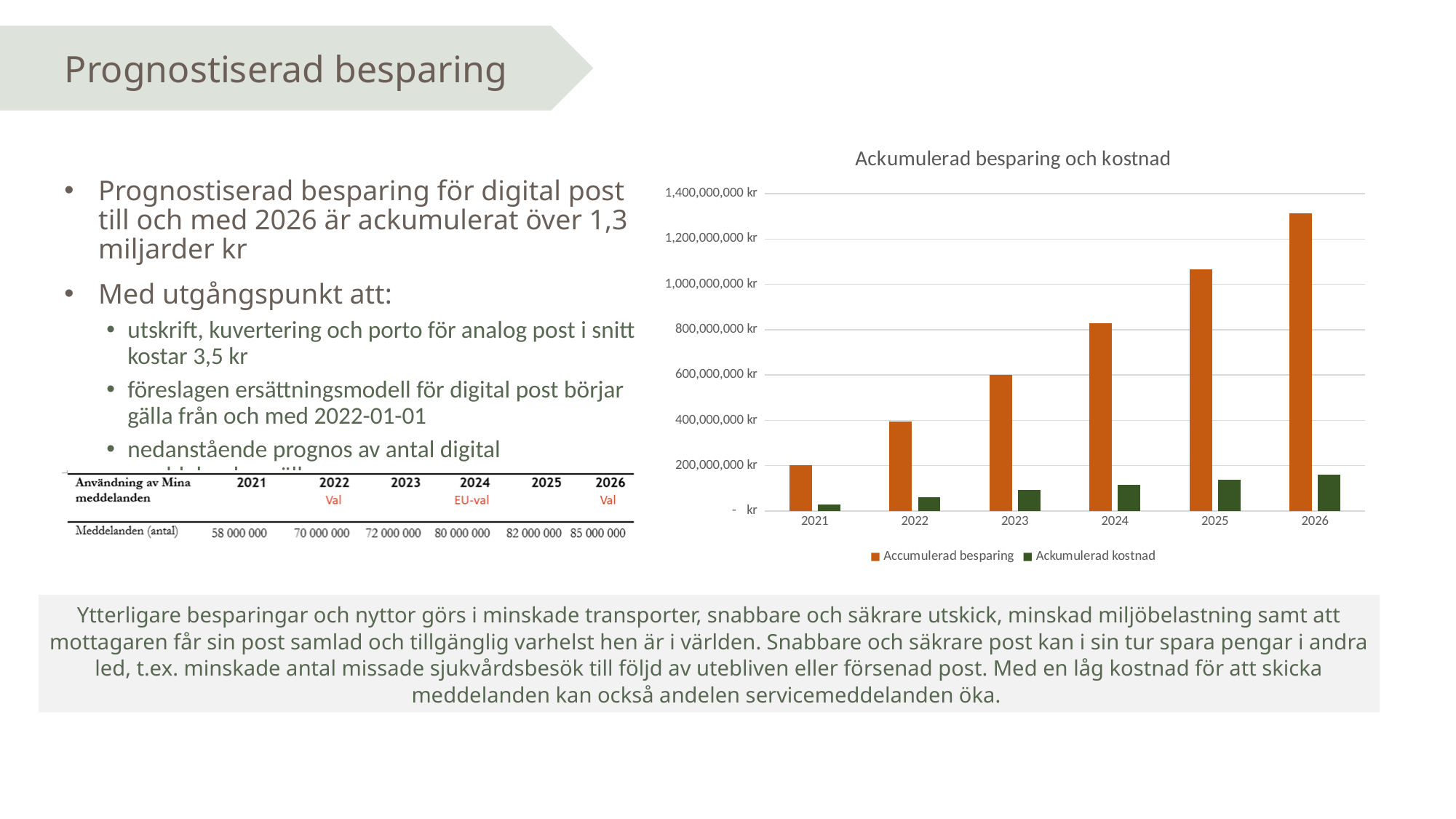
In 2024, which is larger: Accumulerad besparing or Ackumulerad kostnad? Accumulerad besparing Which year has the highest value for Accumulerad besparing? 2026 Do the Accumulerad besparing values rise or fall from 2021 to 2026? rise Is the value for Ackumulerad kostnad in 2026 greater or less than 200,000,000 kr? less Is the value for Accumulerad besparing in 2026 greater or less than 1,200,000,000 kr? greater How many years are shown on the x axis of the chart? 6 Which year has the highest value for Ackumulerad kostnad? 2026 Is the value for Accumulerad besparing in 2025 greater or less than 1,000,000,000 kr? greater Which year has the lowest value for Accumulerad besparing? 2021 What kind of chart is shown on the slide? bar chart How many series does the chart legend list? 2 What is the title of the chart? Ackumulerad besparing och kostnad